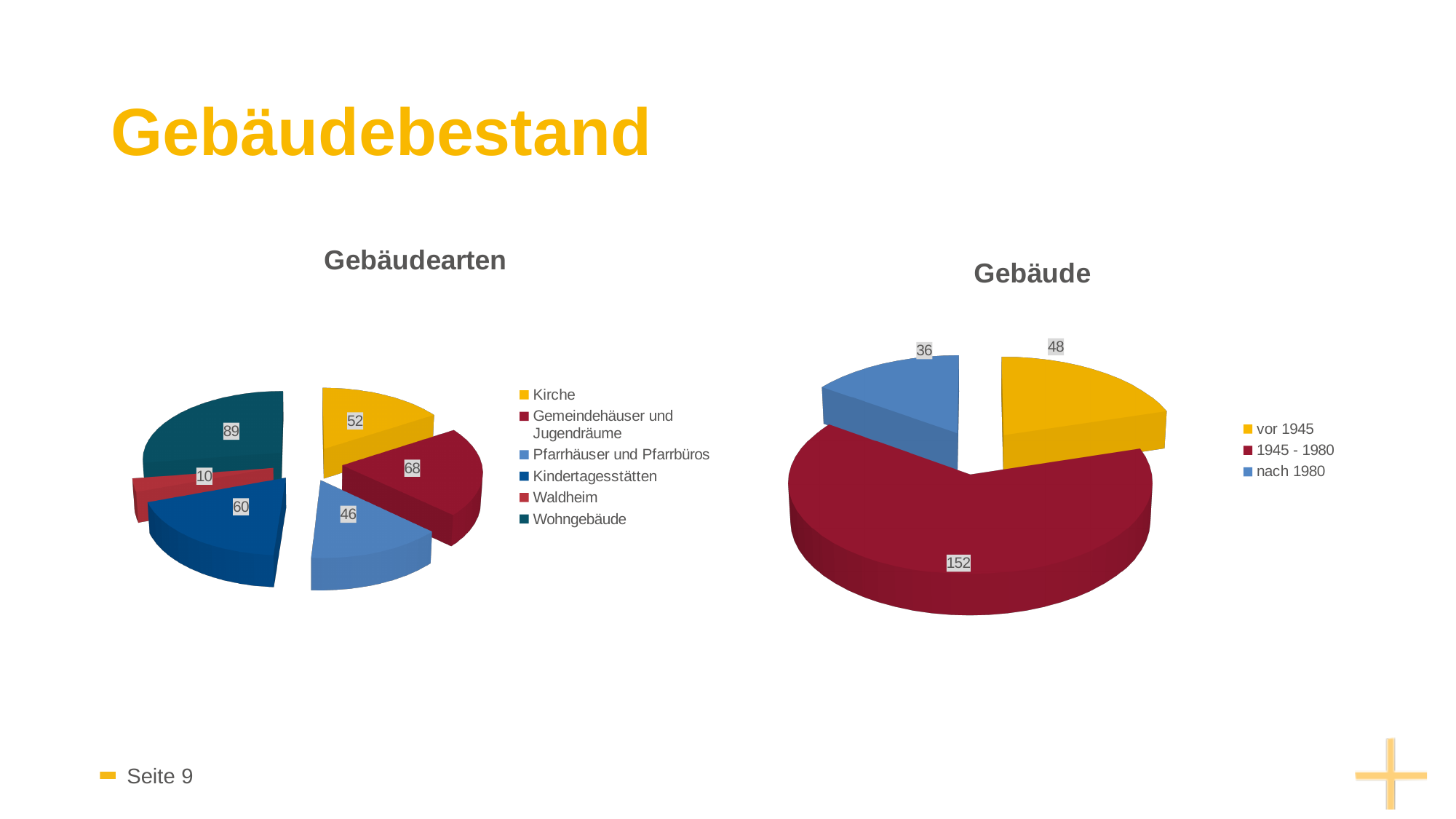
What kind of chart is the Gebäude chart? Pie chart In the Gebäudearten chart, what is the difference between Gemeindehäuser und Jugendräume and Pfarrhäuser und Pfarrbüros? 22 In the Gebäude chart, which category has the smallest value? nach 1980 How many categories does the Gebäudearten chart show? 6 In the Gebäudearten chart, which category has the smallest value? Waldheim In the Gebäudearten chart, which is larger: Kirche or Kindertagesstätten? Kindertagesstätten In the Gebäudearten chart, what is the value for Waldheim? 10 In the Gebäude chart, what is the value for 1945 - 1980? 152 In the Gebäude chart, what is the difference between vor 1945 and nach 1980? 12 In the Gebäudearten chart, what is the value for Wohngebäude? 89 In the Gebäudearten chart, which category has the largest value? Wohngebäude How many entries does the legend of the Gebäude chart list? 3